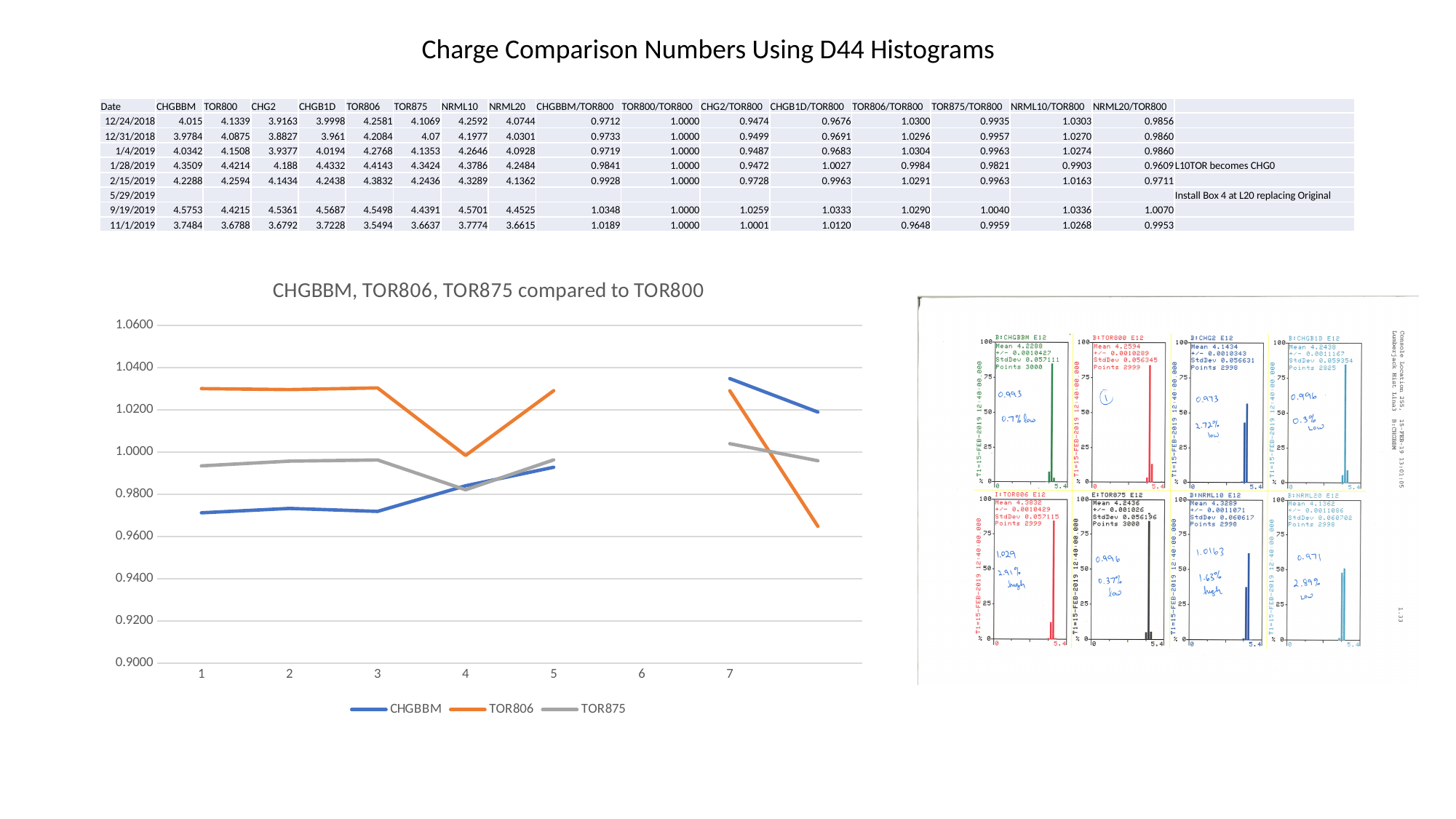
What are the series names in the legend of the line chart? CHGBBM, TOR806, TOR875 In the line chart, which series has the highest value at x = 1? TOR806 In the line chart, is the value for TOR806 at x = 1 greater or less than 1.0200? greater In the line chart, which series has the lowest value at x = 1? CHGBBM In the line chart, is the value for CHGBBM at x = 7 greater or less than 1.0200? greater In the line chart, which colour is used for the TOR806 series? orange In the line chart, does the CHGBBM series rise or fall from x = 1 to x = 5? rise In the line chart, is the value for CHGBBM at x = 1 greater or less than 0.9800? less How many series does the legend of the line chart list? 3 What kind of chart is 'CHGBBM, TOR806, TOR875 compared to TOR800'? line chart In the line chart, at x = 4, which is larger: TOR806 or CHGBBM? TOR806